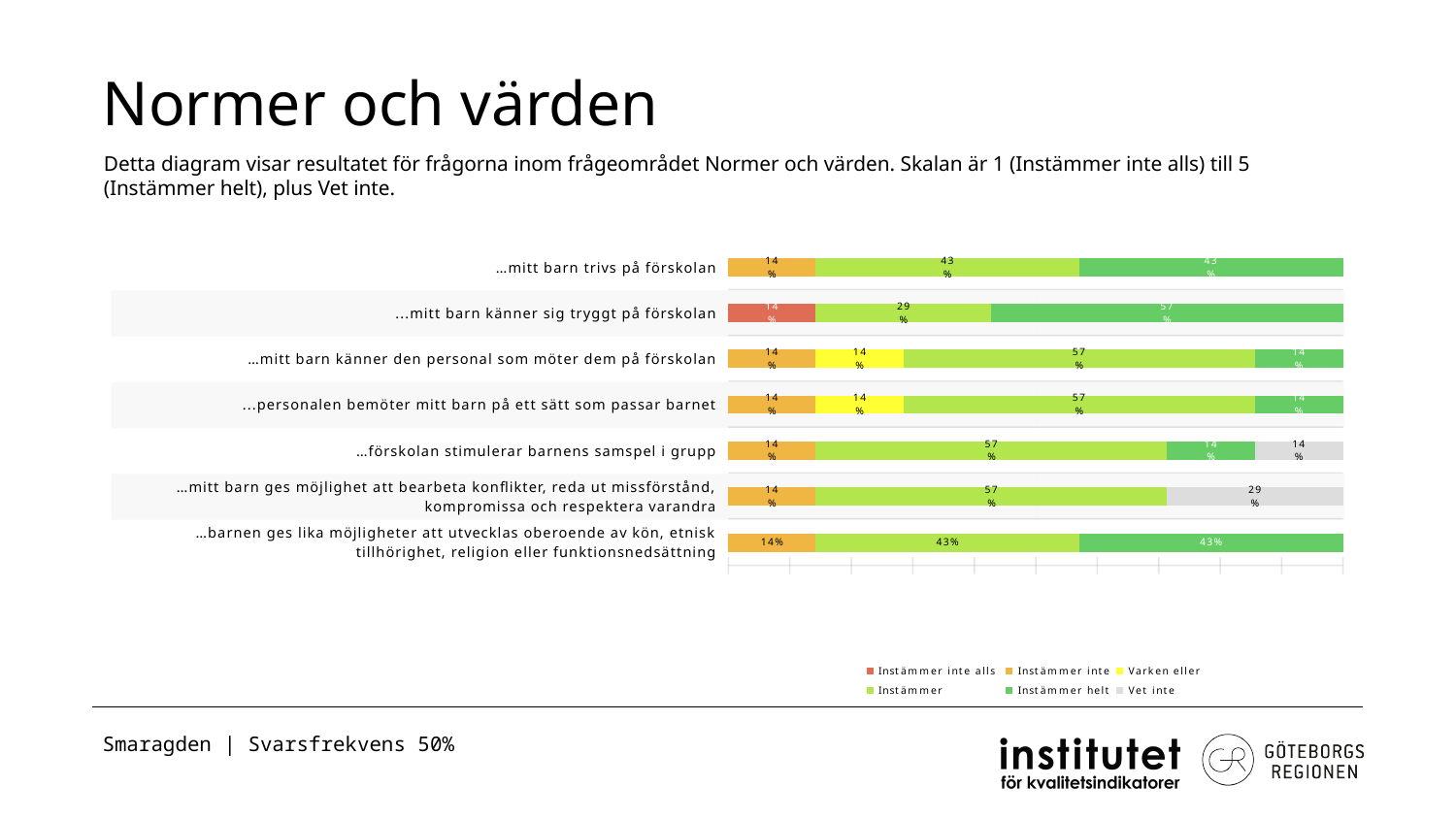
What is the 'Vet inte' share for '…mitt barn ges möjlighet att bearbeta konflikter, reda ut missförstånd, kompromissa och respektera varandra'? 29% What is the difference between the 'Instämmer' share (57%) and the 'Instämmer helt' share (14%) for '…förskolan stimulerar barnens samspel i grupp'? 43% What kind of chart is shown on the slide? Stacked bar chart How many statements (categories) are plotted in the chart? 7 How many series does the legend list? 6 What is the title of the slide containing the chart? Normer och värden What is the combined share of 'Instämmer' and 'Instämmer helt' for '…barnen ges lika möjligheter att utvecklas oberoende av kön, etnisk tillhörighet, religion eller funktionsnedsättning'? 86% What is the 'Instämmer helt' share for '…mitt barn känner sig tryggt på förskolan'? 57% Which is larger for '…mitt barn känner sig tryggt på förskolan': the 'Instämmer' share or the 'Instämmer helt' share? Instämmer helt What is the 'Varken eller' share for '…personalen bemöter mitt barn på ett sätt som passar barnet'? 14% What is the 'Instämmer' share for '…mitt barn trivs på förskolan'? 43% Which statement has the highest 'Instämmer helt' share? …mitt barn känner sig tryggt på förskolan